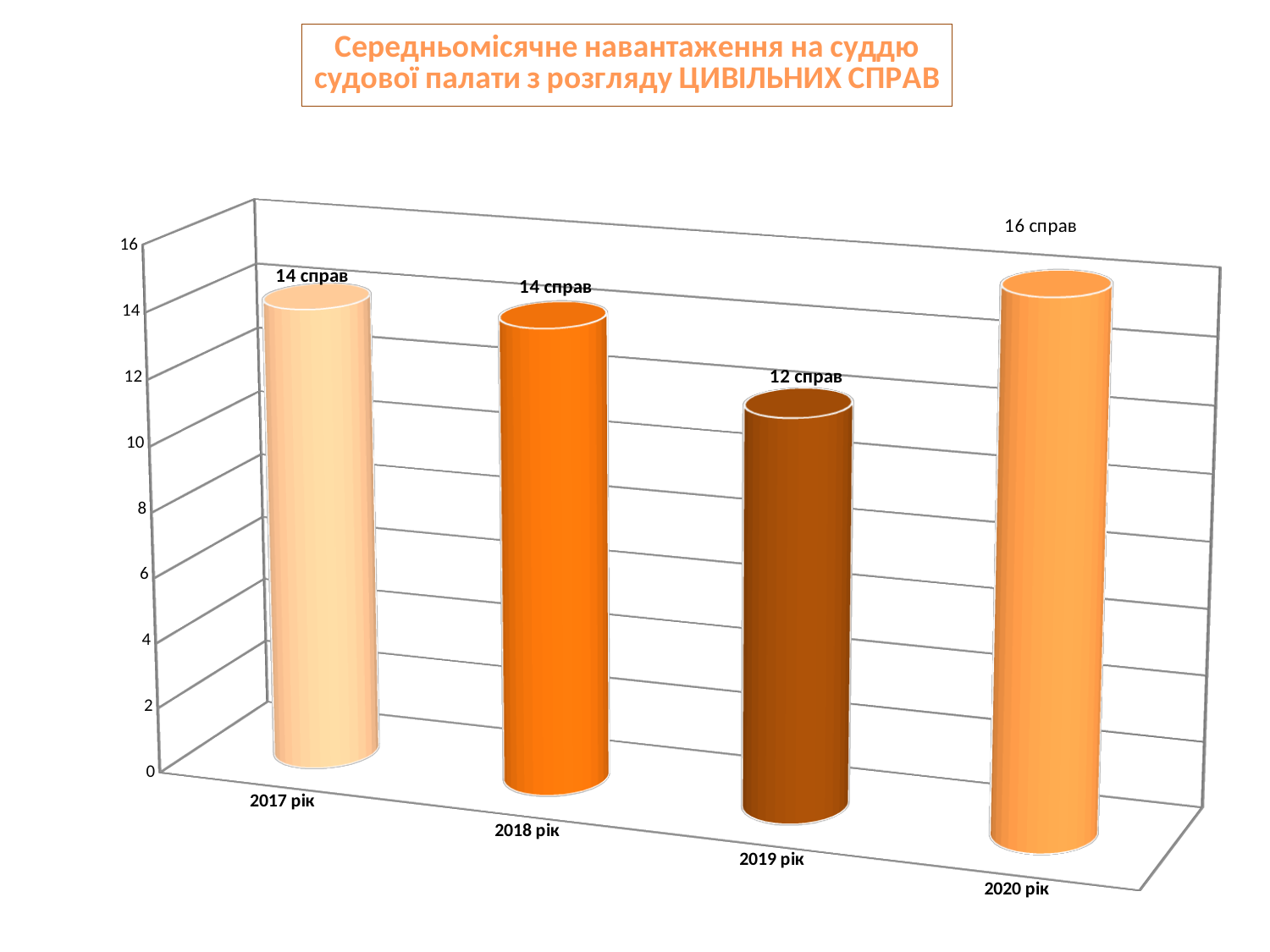
What is the title of the chart? Середньомісячне навантаження на суддю судової палати з розгляду ЦИВІЛЬНИХ СПРАВ Which year has the lowest value? 2019 рік Is the value for 2020 рік greater or less than 14? greater What is the value for 2019 рік? 12 справ What is the difference between the values for 2020 рік and 2019 рік? 4 справ Which is larger, the value for 2017 рік or the value for 2019 рік? 2017 рік What is the difference between the values for 2018 рік and 2019 рік? 2 справ What is the value for 2017 рік? 14 справ Which year has the highest value? 2020 рік What kind of chart is shown on the slide? bar chart How many years are shown on the chart? 4 What is the value for 2020 рік? 16 справ